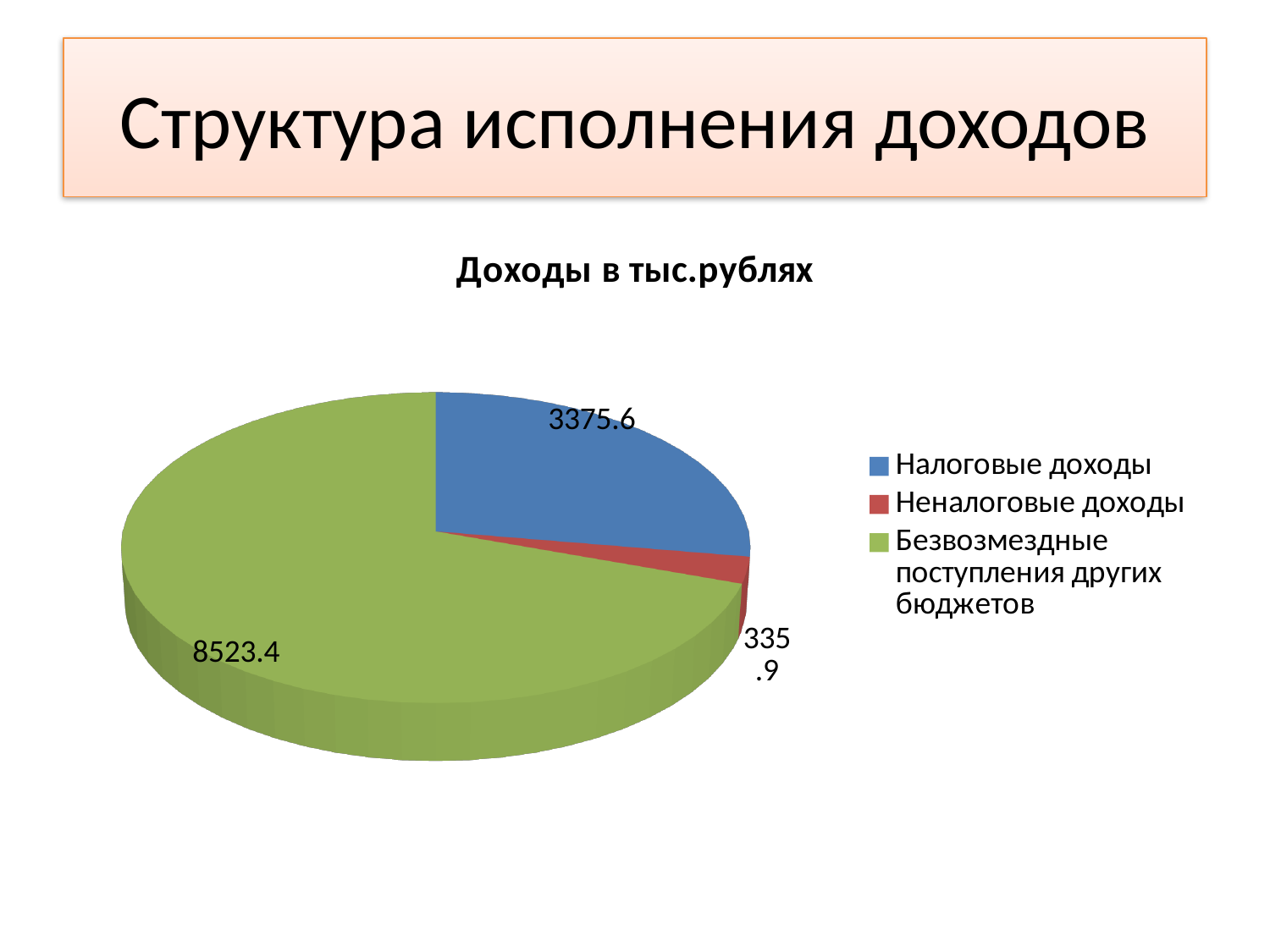
What is the title of the chart? Доходы в тыс.рублях What is the value for Налоговые доходы? 3375.6 How many slices does the pie chart have? 3 What colour is the slice for Неналоговые доходы? Red What is the value for Безвозмездные поступления других бюджетов? 8523.4 How many entries does the legend list? 3 Which category has the smallest slice of the pie? Неналоговые доходы What is the difference between the values for Безвозмездные поступления других бюджетов and Налоговые доходы? 5147.8 Which is larger, Налоговые доходы or Неналоговые доходы? Налоговые доходы What kind of chart is shown on the slide? Pie chart Which category has the largest slice of the pie? Безвозмездные поступления других бюджетов What is the value for Неналоговые доходы? 335.9